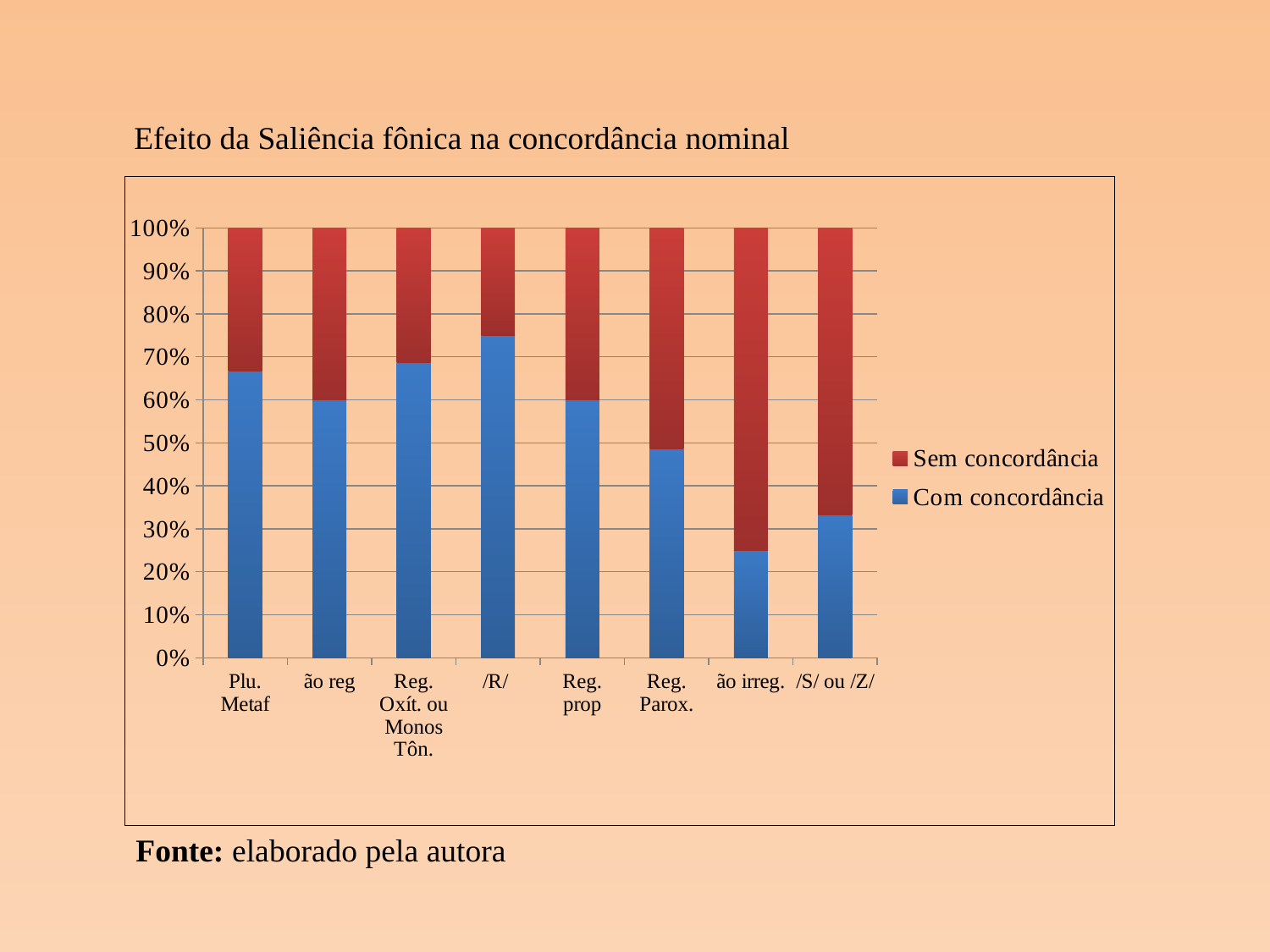
What kind of chart is shown on the slide? stacked bar chart How many categories are shown along the x axis of the chart? 8 Is the Com concordância value for Reg. Parox. greater or less than 50%? less Which has a larger Com concordância share, Plu. Metaf or /S/ ou /Z/? Plu. Metaf Which category has the lowest share of Com concordância? ão irreg. Is the Com concordância value for ão irreg. greater or less than 30%? less How many series does the legend list? 2 Is the Com concordância value for /R/ greater or less than 70%? greater What is the total height of each stacked bar in the chart? 100% Which category has the largest share of Sem concordância? ão irreg. Which category has the highest share of Com concordância? /R/ Which colour represents Sem concordância in the chart? red